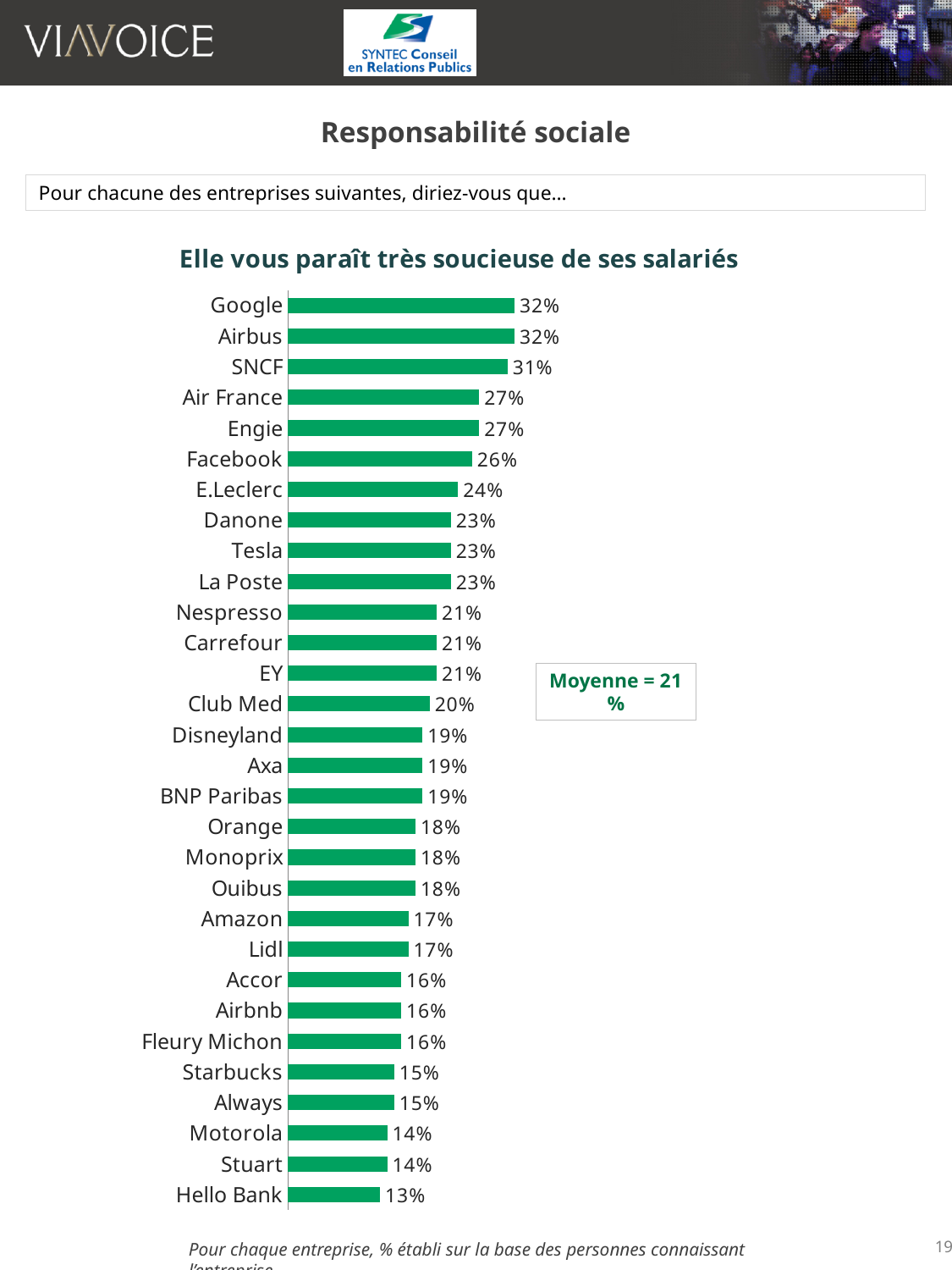
What is the difference between the values for Google and Hello Bank? 19% What kind of chart is shown on the slide? Bar chart Which has a larger value, Facebook or Carrefour? Facebook How many companies are shown in the chart? 30 What is the value for Starbucks? 15% What is the title of the chart? Elle vous paraît très soucieuse de ses salariés What is the value for Tesla? 23% What is the difference between the values for Air France and Amazon? 10% Which has a larger value, Motorola or Club Med? Club Med Which company has the lowest value? Hello Bank What average value (Moyenne) is indicated on the chart? 21 % What is the value for SNCF? 31%